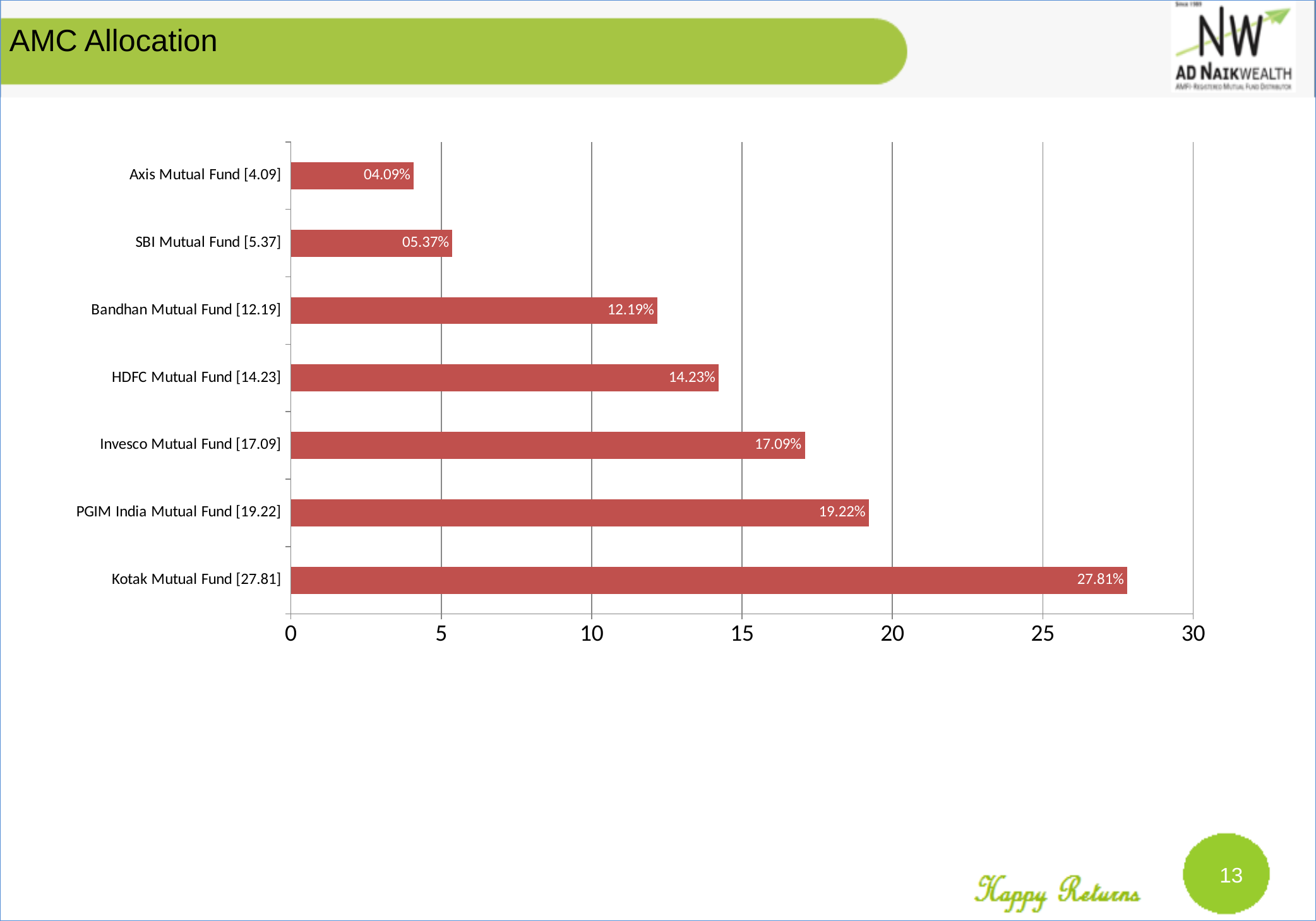
Which is larger, the value for Invesco Mutual Fund or the value for Bandhan Mutual Fund? Invesco Mutual Fund What is the value shown for Kotak Mutual Fund? 27.81% What is the value shown for Axis Mutual Fund? 04.09% Which fund has the highest allocation? Kotak Mutual Fund How many funds are shown in the chart? 7 Which fund has the lowest allocation? Axis Mutual Fund What is the value shown for HDFC Mutual Fund? 14.23% What is the highest value shown on the horizontal axis? 30 What kind of chart is shown on the slide? Bar chart Is the value for SBI Mutual Fund greater or less than 5? greater What is the title of the slide? AMC Allocation What is the difference between the values for Kotak Mutual Fund and PGIM India Mutual Fund? 8.59